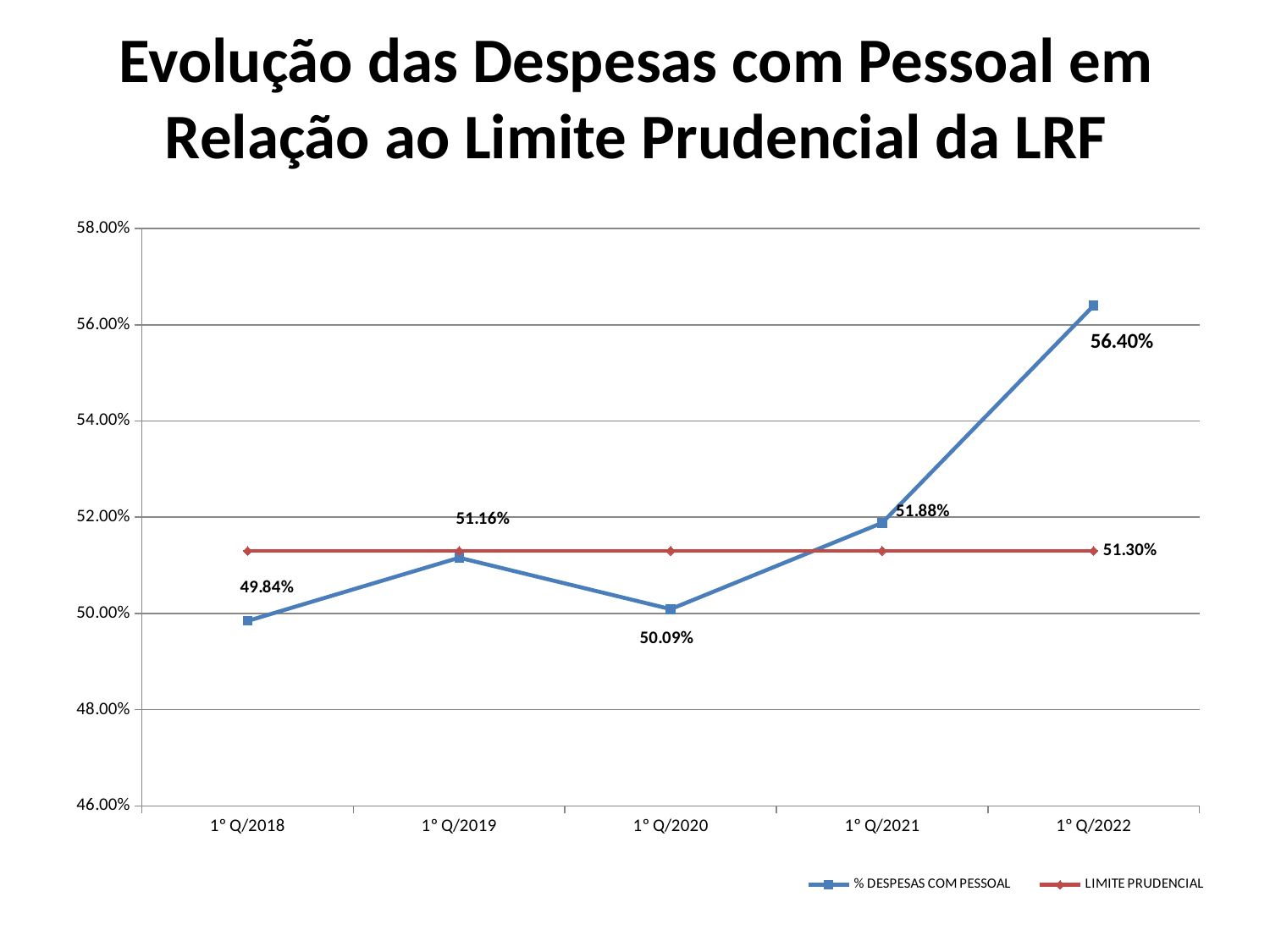
In which period is % DESPESAS COM PESSOAL lowest? 1° Q/2018 What is the difference between % DESPESAS COM PESSOAL in 1° Q/2022 and 1° Q/2021? 4.52% Which is larger, % DESPESAS COM PESSOAL in 1° Q/2019 or in 1° Q/2020? 1° Q/2019 Is the value of % DESPESAS COM PESSOAL for 1° Q/2021 greater or less than 52.00%? less What value is labelled on the LIMITE PRUDENCIAL line at 1° Q/2022? 51.30% How many series does the legend list? 2 What is the value of % DESPESAS COM PESSOAL for 1° Q/2022? 56.40% What is the value of % DESPESAS COM PESSOAL for 1° Q/2020? 50.09% What is the value of % DESPESAS COM PESSOAL for 1° Q/2018? 49.84% In which period is % DESPESAS COM PESSOAL highest? 1° Q/2022 What kind of chart is shown on the slide? line chart How many periods are shown on the x axis? 5